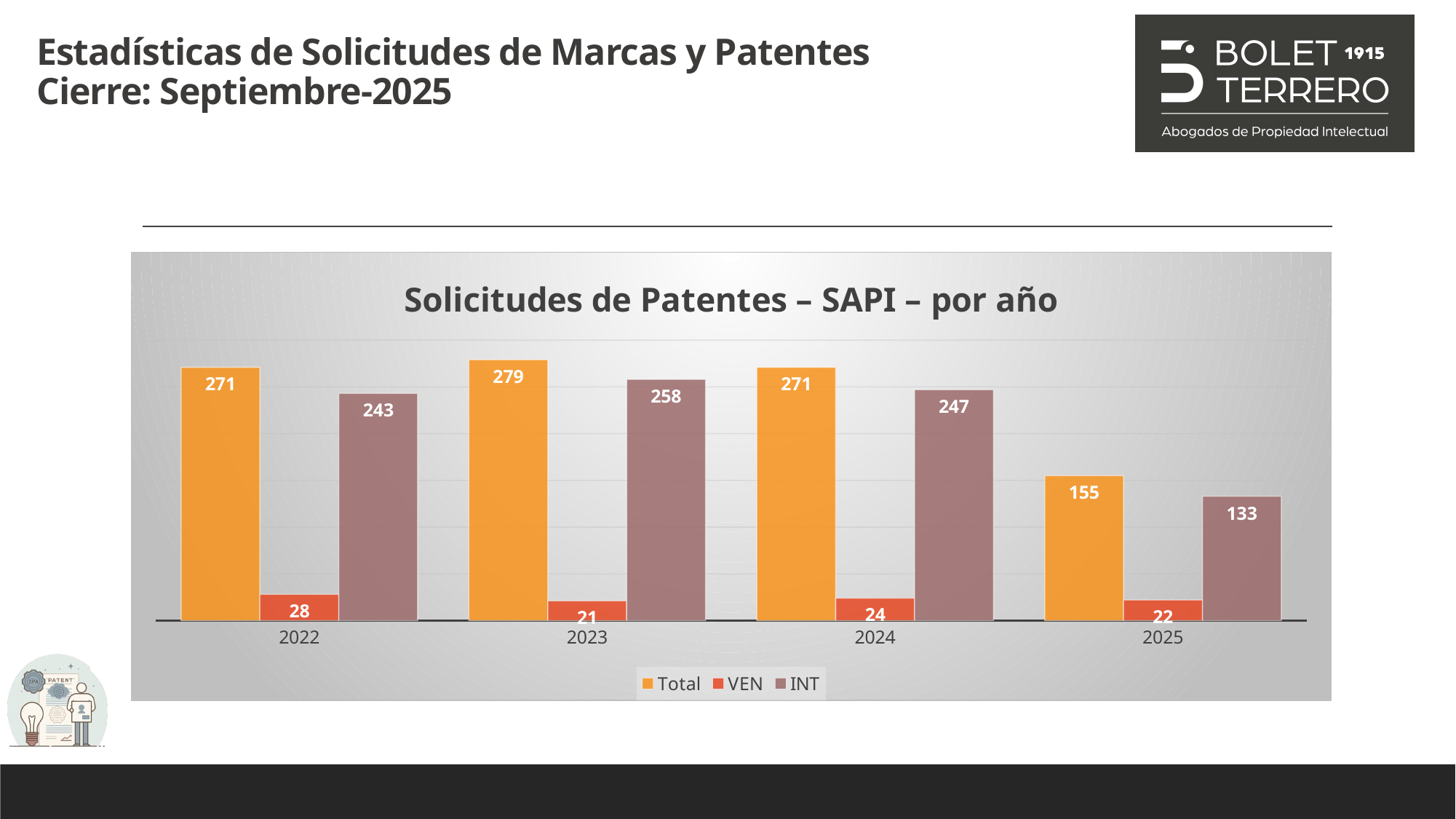
Which year has the lowest VEN value? 2023 What is the title of the chart? Solicitudes de Patentes – SAPI – por año Which is larger, the INT value for 2022 or the INT value for 2023? 2023 How many series does the legend list? 3 How many years are shown on the x axis? 4 What is the INT value for 2024? 247 Which year has the highest Total value? 2023 What kind of chart is shown on the slide? Bar chart What is the VEN value for 2022? 28 What is the Total value for 2023? 279 What is the difference between the Total values for 2024 and 2025? 116 What is the INT value for 2025? 133